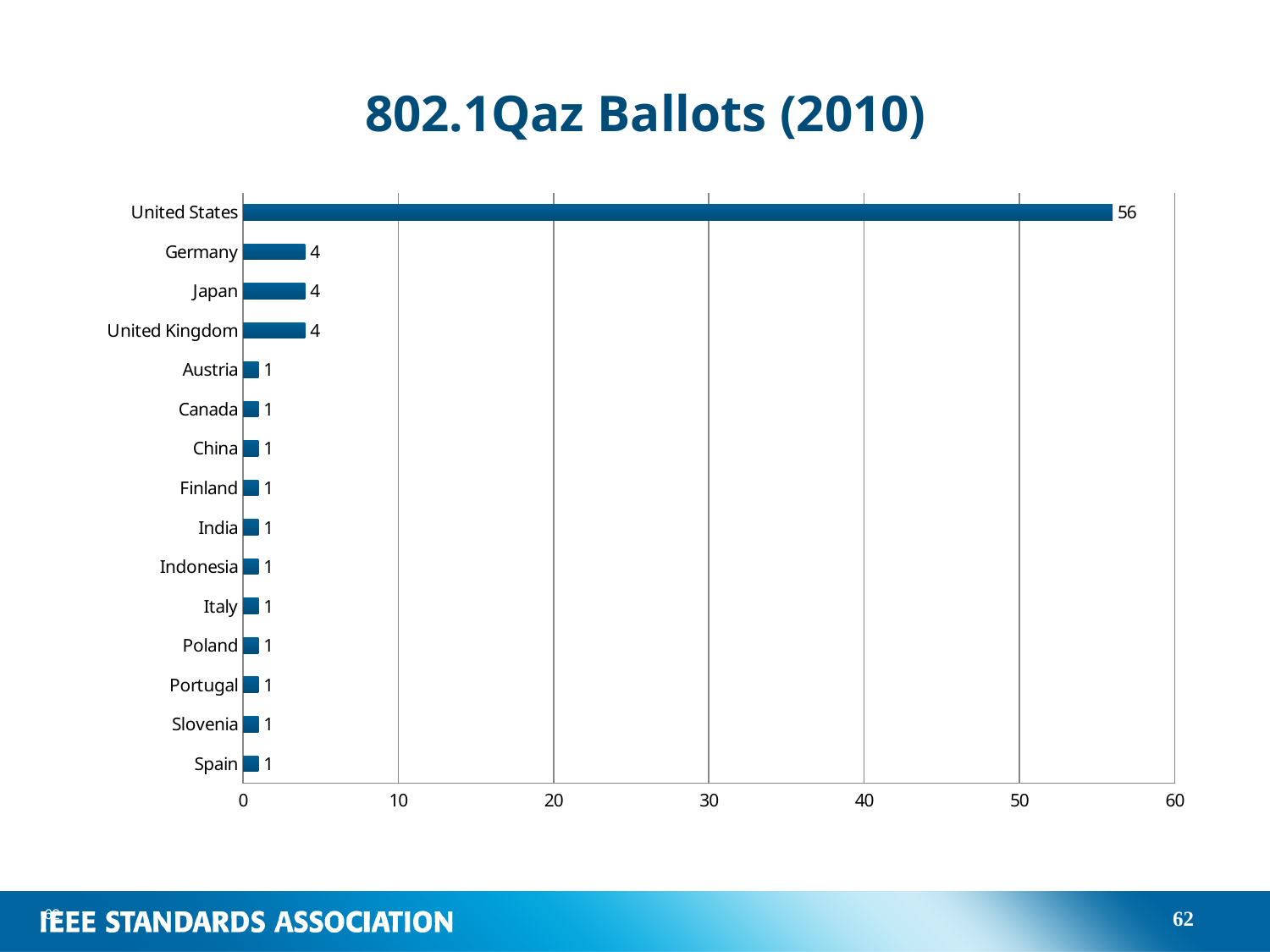
Is the value for United States greater or less than 50? greater Which country has the highest number of ballots? United States Which is larger, the value for Germany or the value for Canada? Germany What is the difference between the values for United Kingdom and Austria? 3 What kind of chart is shown on the slide? bar chart How many countries are shown in the chart? 15 What is the value for Germany? 4 What is the value for Slovenia? 1 What is the difference between the values for United States and Japan? 52 What is the value for United States? 56 What is the title of the chart? 802.1Qaz Ballots (2010) How many countries have a value of 4? 3